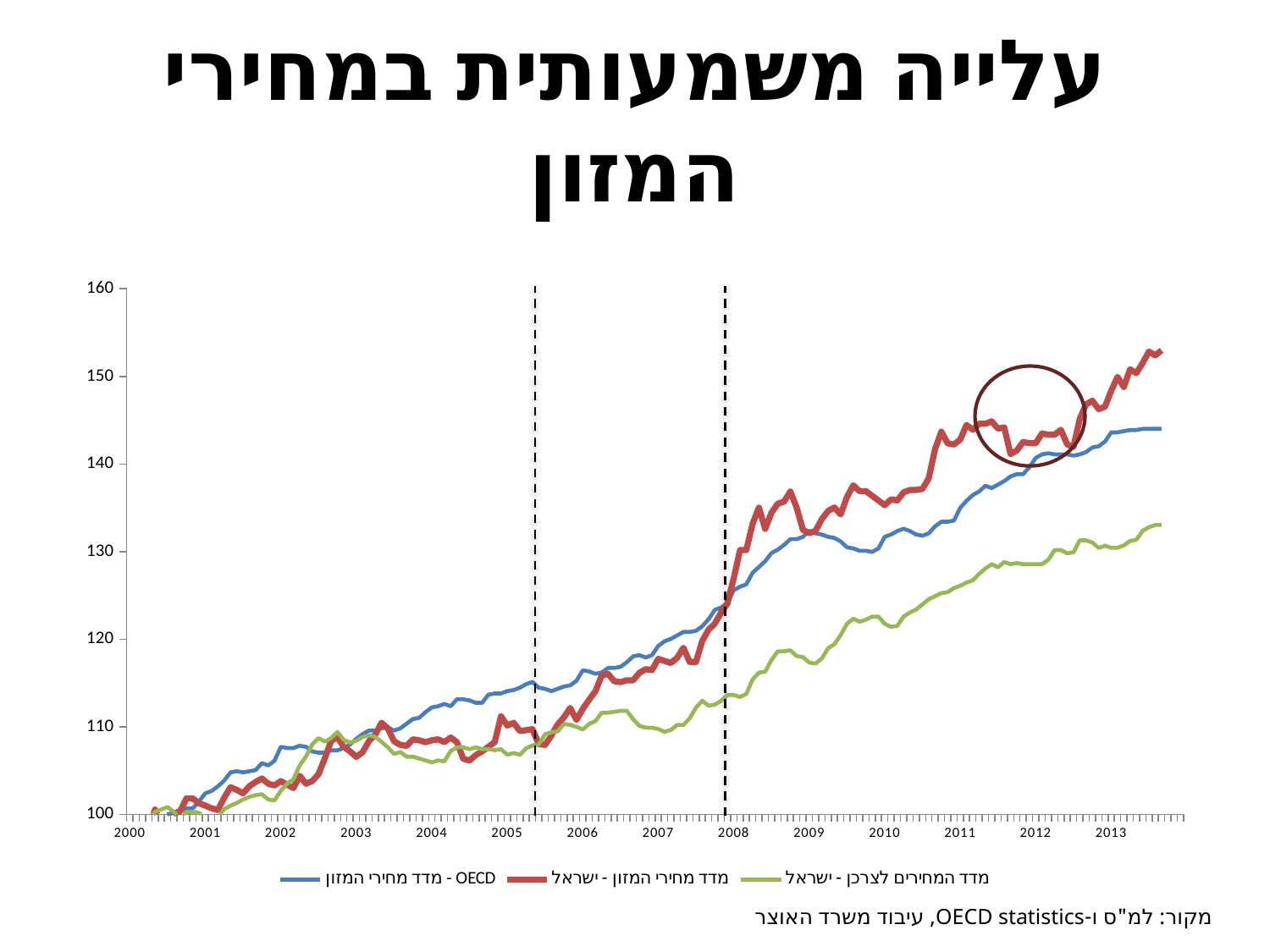
Do the values of the series generally rise or fall from 2000 to 2013? rise Is the value of the series 'מדד מחירי המזון - ישראל' at the end of 2013 greater or less than 150? greater Is the value of the series 'מדד מחירי המזון - OECD' at the end of 2013 greater or less than 140? greater Is the value of the series 'מדד מחירי המזון - OECD' at 2005 greater or less than 110? greater What is the highest value shown on the y axis? 160 How many series does the legend list? 3 What kind of chart is shown on the slide? line chart At the end of 2013, which series is higher: 'מדד מחירי המזון - ישראל' or 'מדד המחירים לצרכן - ישראל'? מדד מחירי המזון - ישראל Which series has the lowest value at the end of 2013? מדד המחירים לצרכן - ישראל At the end of 2013, which series is higher: 'מדד מחירי המזון - ישראל' or 'מדד מחירי המזון - OECD'? מדד מחירי המזון - ישראל Which series has the highest value at the end of 2013? מדד מחירי המזון - ישראל